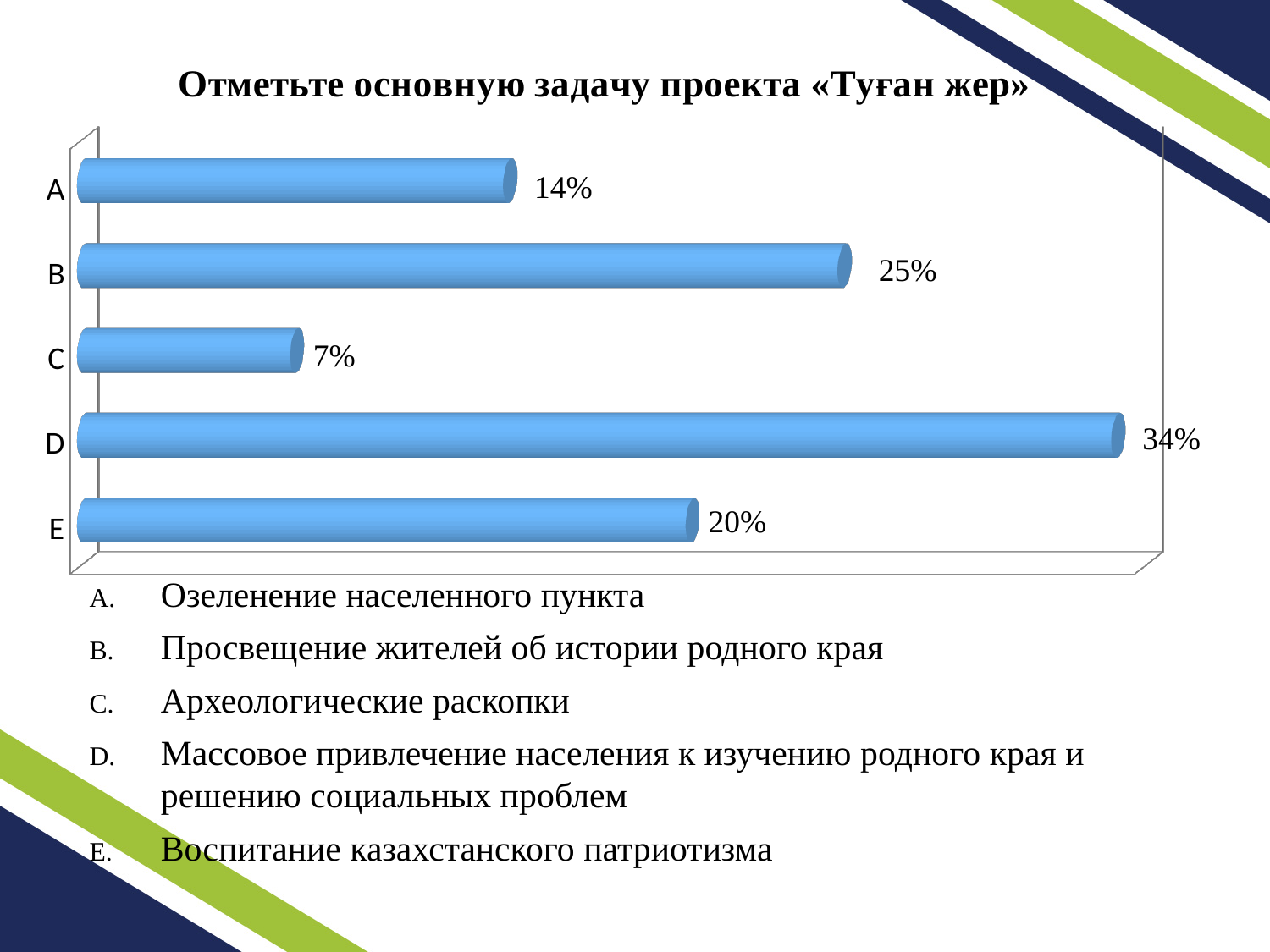
What is the difference between the values for D and B? 9% Which category has the lowest value? C What is the value for category B? 25% What kind of chart is shown on the slide? Bar chart Which is larger, the value for B or the value for E? B What is the value for category E? 20% What is the title of the chart? Отметьте основную задачу проекта «Туған жер» What is the value for category D? 34% What is the value for category A? 14% How many categories are shown in the chart? 5 Which category has the highest value? D What is the value for category C? 7%